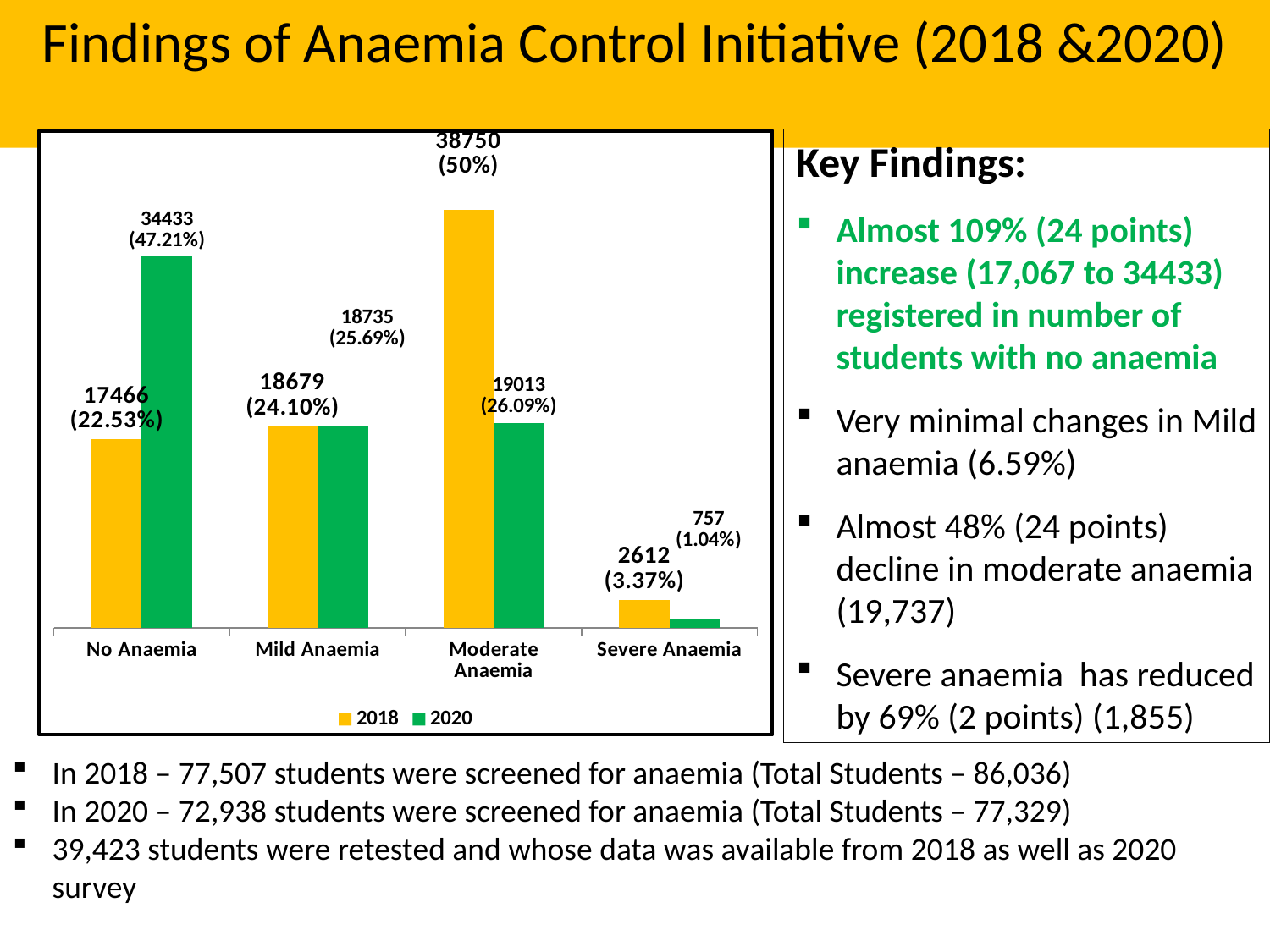
Which category has the highest 2018 value? Moderate Anaemia What is the 2018 value for No Anaemia? 17466 How many series does the legend list? 2 What is the 2020 value for No Anaemia? 34433 What is the 2020 value for Severe Anaemia? 757 What is the difference between the 2018 and 2020 values for Moderate Anaemia? 19737 What percentage is shown for Mild Anaemia in 2020? 25.69% How many categories are shown on the x axis? 4 Which category has the lowest 2020 value? Severe Anaemia What is the difference between the 2020 and 2018 values for No Anaemia? 16967 What is the 2018 value for Moderate Anaemia? 38750 For Severe Anaemia, which year has the larger value, 2018 or 2020? 2018